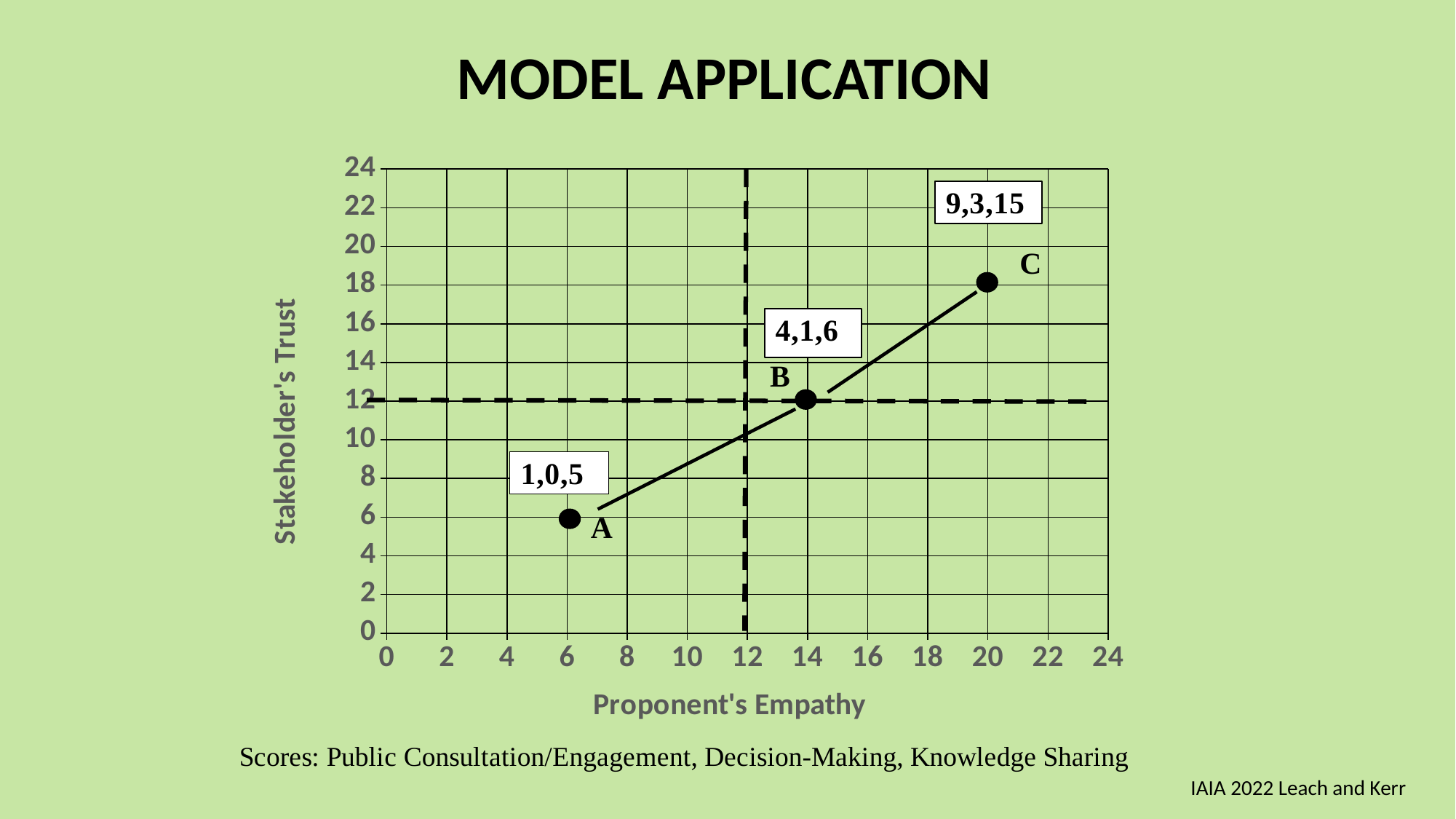
Which point has the highest Stakeholder's Trust value? C What is the Proponent's Empathy value for point B? 14 What is the Stakeholder's Trust value for point C? 18 Which point has a larger Stakeholder's Trust value, A or B? B What is the difference in Stakeholder's Trust between point C and point A? 12 What is the title of the x axis? Proponent's Empathy Which point has the lowest Proponent's Empathy value? A How many labelled points are plotted on the chart? 3 What is the Stakeholder's Trust value for point A? 6 What is the Proponent's Empathy value for point C? 20 Do the Stakeholder's Trust values rise or fall as Proponent's Empathy increases from A to C? Rise What kind of chart is shown on the slide? Scatter chart